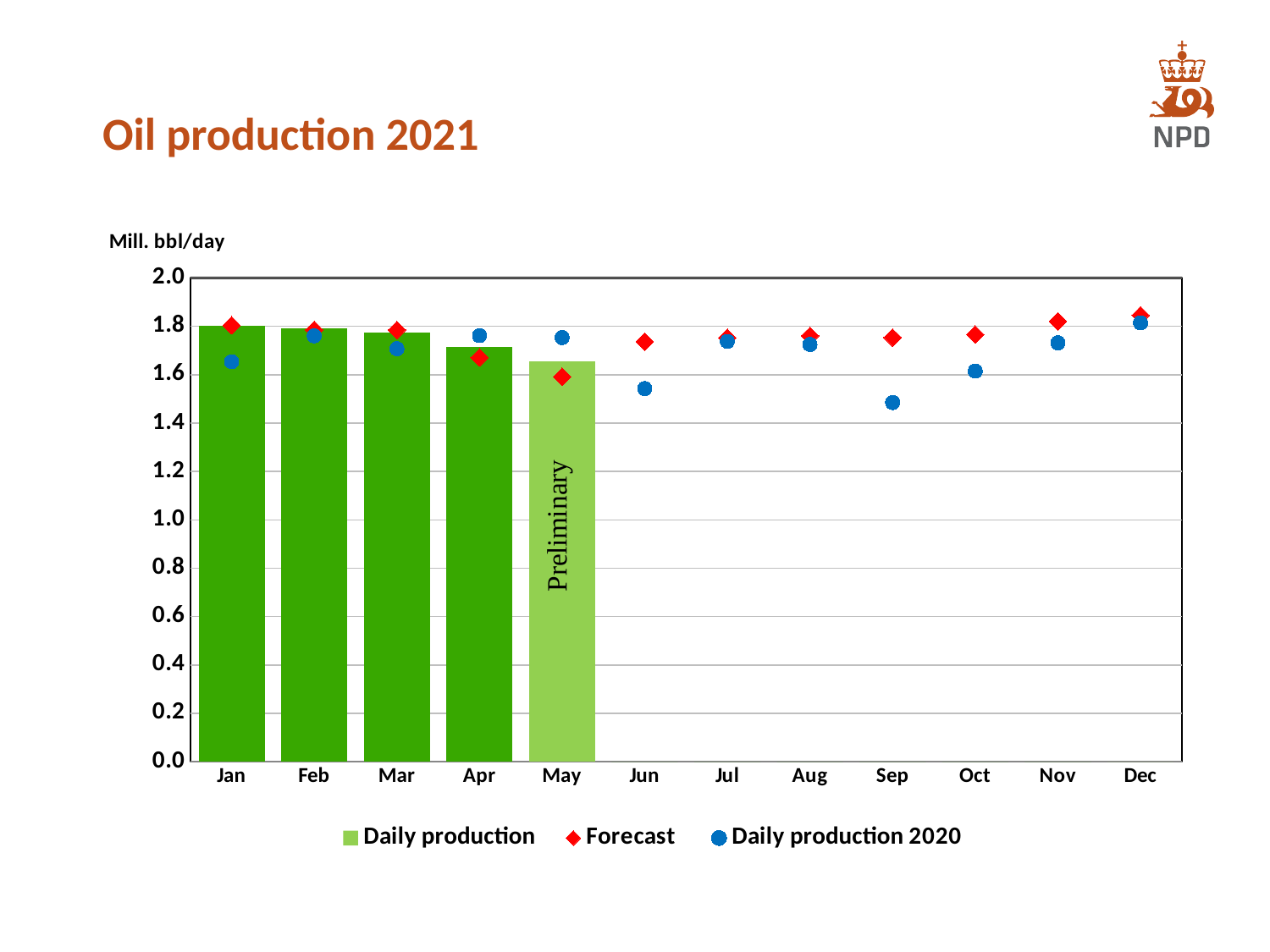
What unit is shown on the y axis? Mill. bbl/day Which month has the lowest Daily production 2020 value? Sep In Sep, which is larger: the Forecast or the Daily production 2020 value? Forecast Is the Daily production 2020 value for Jun greater or less than 1.6? less Which month has the lowest Daily production bar? May Is the Forecast value for Dec greater or less than 1.8? greater How many series does the legend list? 3 Is the Daily production bar for May greater or less than 1.8? less Do the Daily production bars rise or fall from Jan to May? fall How many months have a Daily production bar plotted? 5 How many months are shown on the x axis? 12 What word is written on the May bar? Preliminary